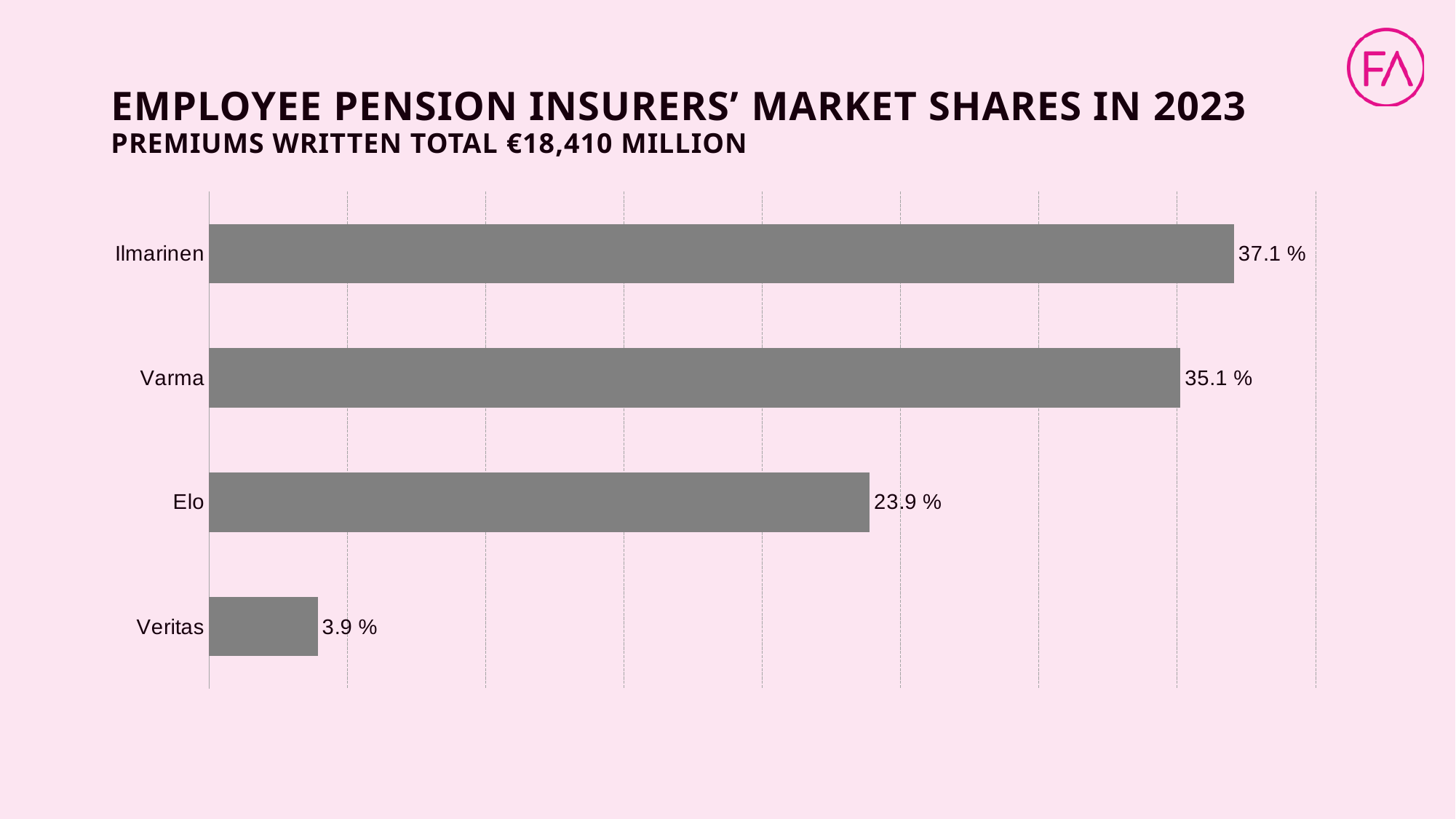
What total of premiums written is stated in the chart subtitle? €18,410 million What is the market share of Ilmarinen? 37.1 % How many insurers are shown in the chart? 4 Which insurer has the highest market share? Ilmarinen What is the market share of Varma? 35.1 % What is the market share of Veritas? 3.9 % Which has a larger market share, Varma or Elo? Varma What is the difference in market share between Elo and Veritas? 20.0 % What is the difference in market share between Ilmarinen and Varma? 2.0 % Which insurer has the lowest market share? Veritas What kind of chart is shown on the slide? Bar chart What is the market share of Elo? 23.9 %